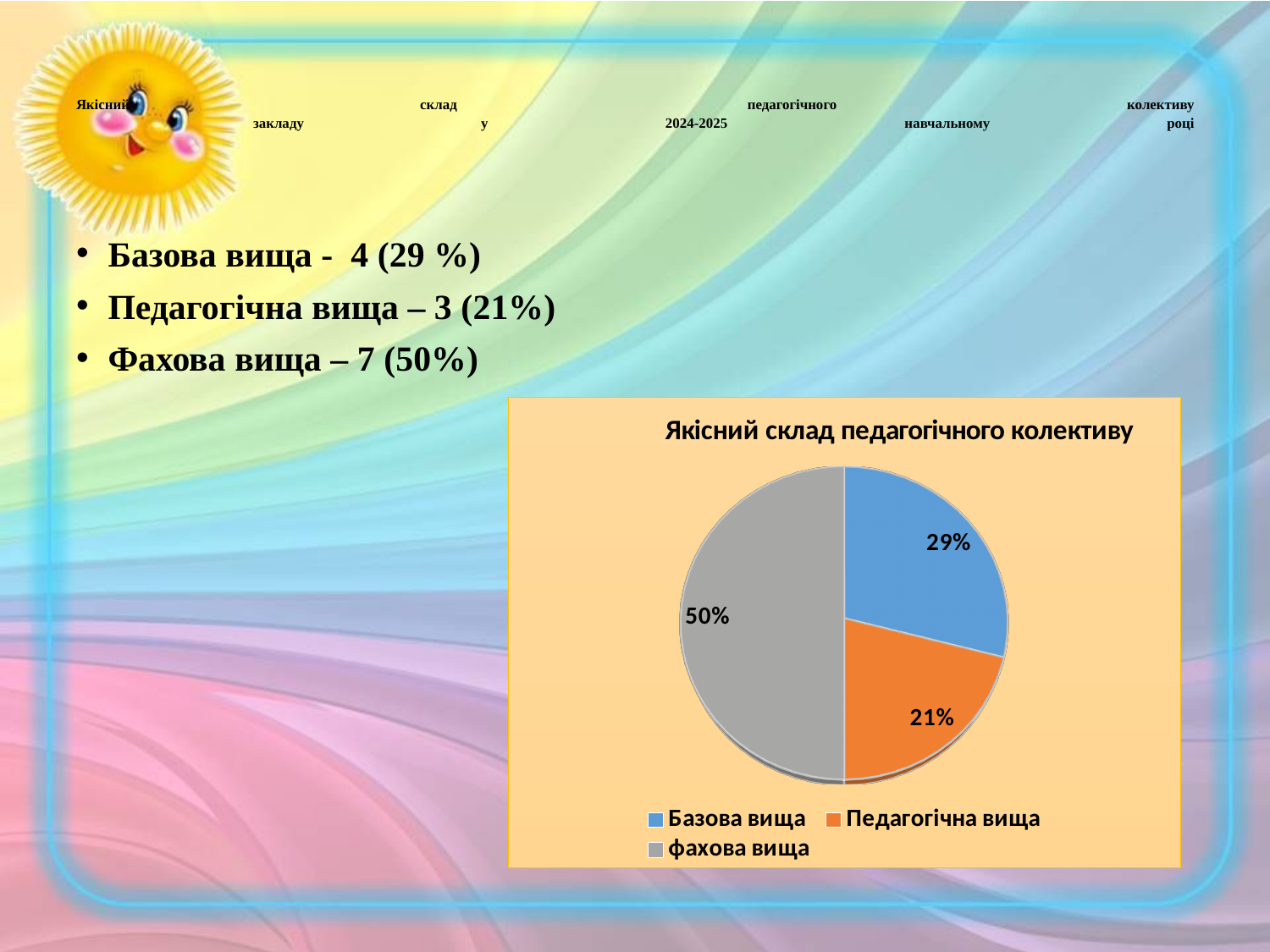
What percentage is shown for Базова вища? 29% What is the title of the chart? Якісний склад педагогічного колективу What percentage is shown for фахова вища? 50% What share of the pie does Педагогічна вища take? 21% How many categories does the legend list? 3 Which category has the smallest slice of the pie? Педагогічна вища Which is larger, the slice for Базова вища or the slice for Педагогічна вища? Базова вища What percentage is shown for Педагогічна вища? 21% What colour is the slice for фахова вища? grey Which category has the largest slice of the pie? фахова вища What type of chart is shown on the slide? pie chart What is the difference in percentage points between фахова вища and Базова вища? 21